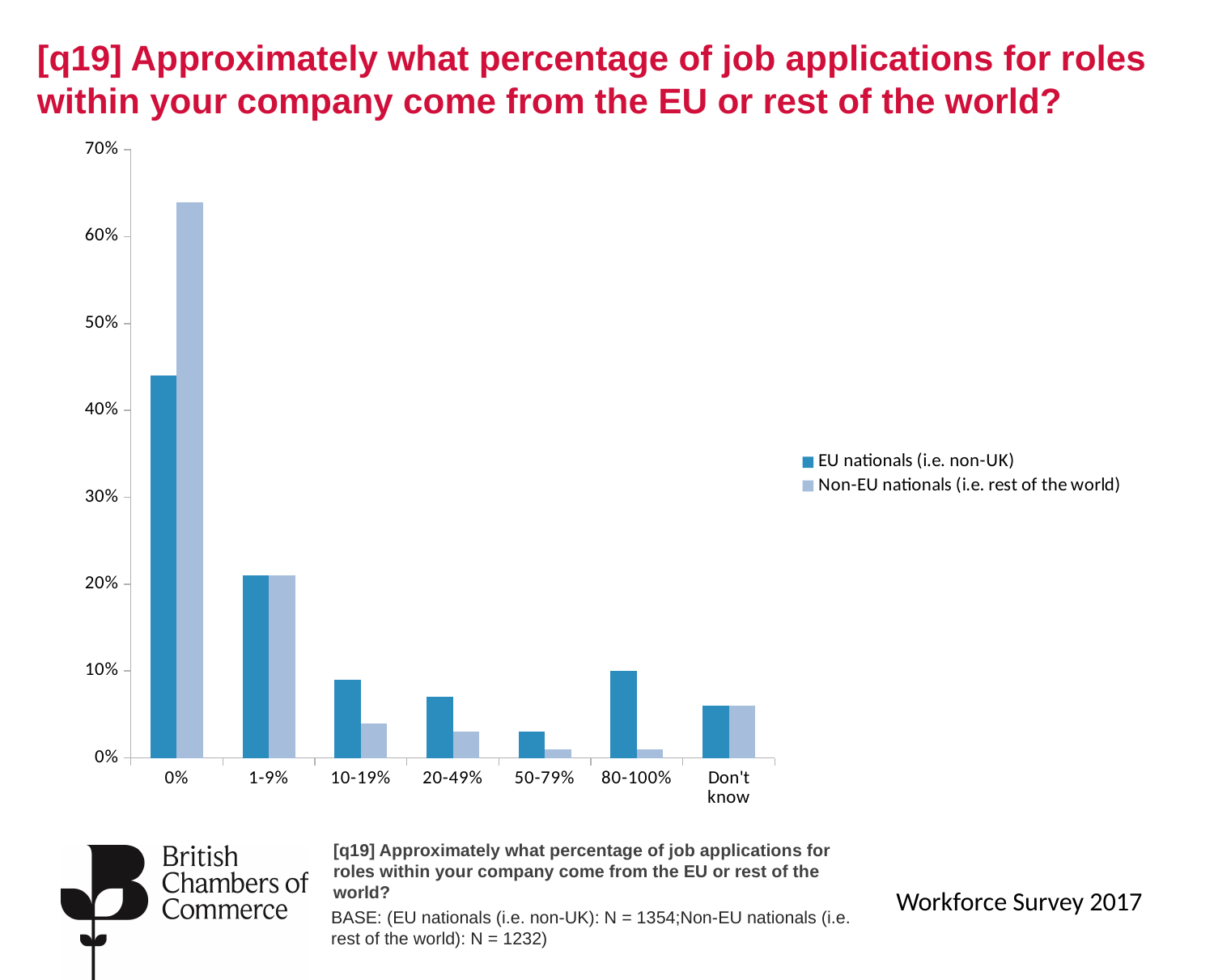
In the 0% category, which series has the larger value: EU nationals or Non-EU nationals? Non-EU nationals (i.e. rest of the world) Which category has the highest value for Non-EU nationals (i.e. rest of the world)? 0% What kind of chart is shown on the slide? Bar chart Which category has the lowest value for EU nationals (i.e. non-UK)? 50-79% Is the value for EU nationals in the 0% category greater or less than 50%? less Is the value for Non-EU nationals in the 0% category greater or less than 60%? greater Which category has the highest value for EU nationals (i.e. non-UK)? 0% How many series does the legend list? 2 How many categories are shown on the x axis? 7 Is the value for Non-EU nationals in the 80-100% category greater or less than 10%? less In the 80-100% category, which series has the larger value: EU nationals or Non-EU nationals? EU nationals (i.e. non-UK)